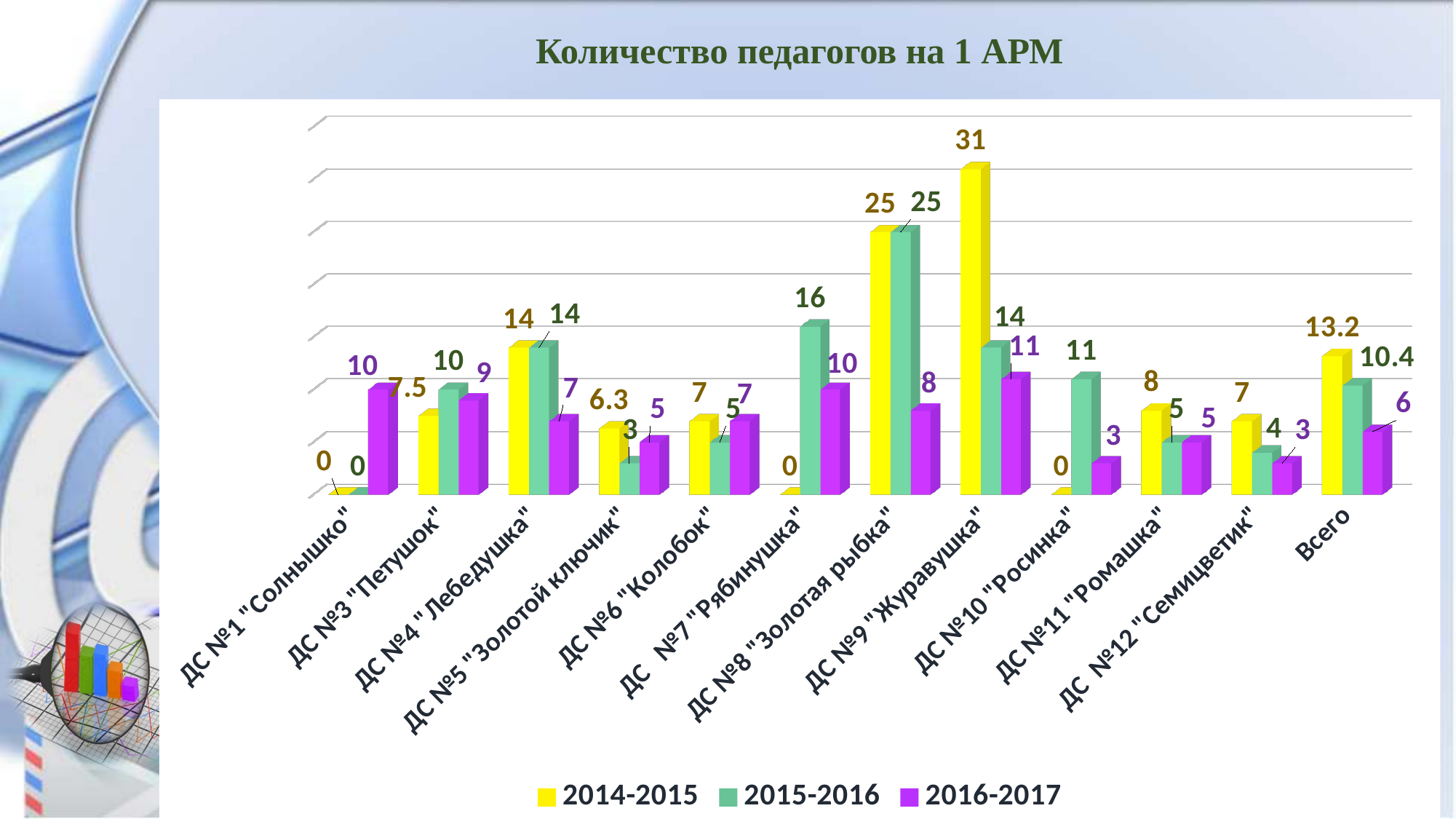
Which is larger for ДС №10 "Росинка": the 2015-2016 value or the 2016-2017 value? 2015-2016 How many categories are shown on the x axis? 12 Which category has the lowest value in the 2016-2017 series? ДС №10 "Росинка" and ДС №12 "Семицветик" (both 3) What is the value for Всего in the 2016-2017 series? 6 What is the value for ДС №7 "Рябинушка" in the 2015-2016 series? 16 How many series does the legend list? 3 What is the difference between the 2014-2015 and 2016-2017 values for ДС №8 "Золотая рыбка"? 17 Do the values for Всего rise or fall from 2014-2015 to 2016-2017? fall What is the value for ДС №9 "Журавушка" in the 2014-2015 series? 31 Which category has the highest value in the 2014-2015 series? ДС №9 "Журавушка" What type of chart is shown on the slide? bar chart What is the title of the chart? Количество педагогов на 1 АРМ